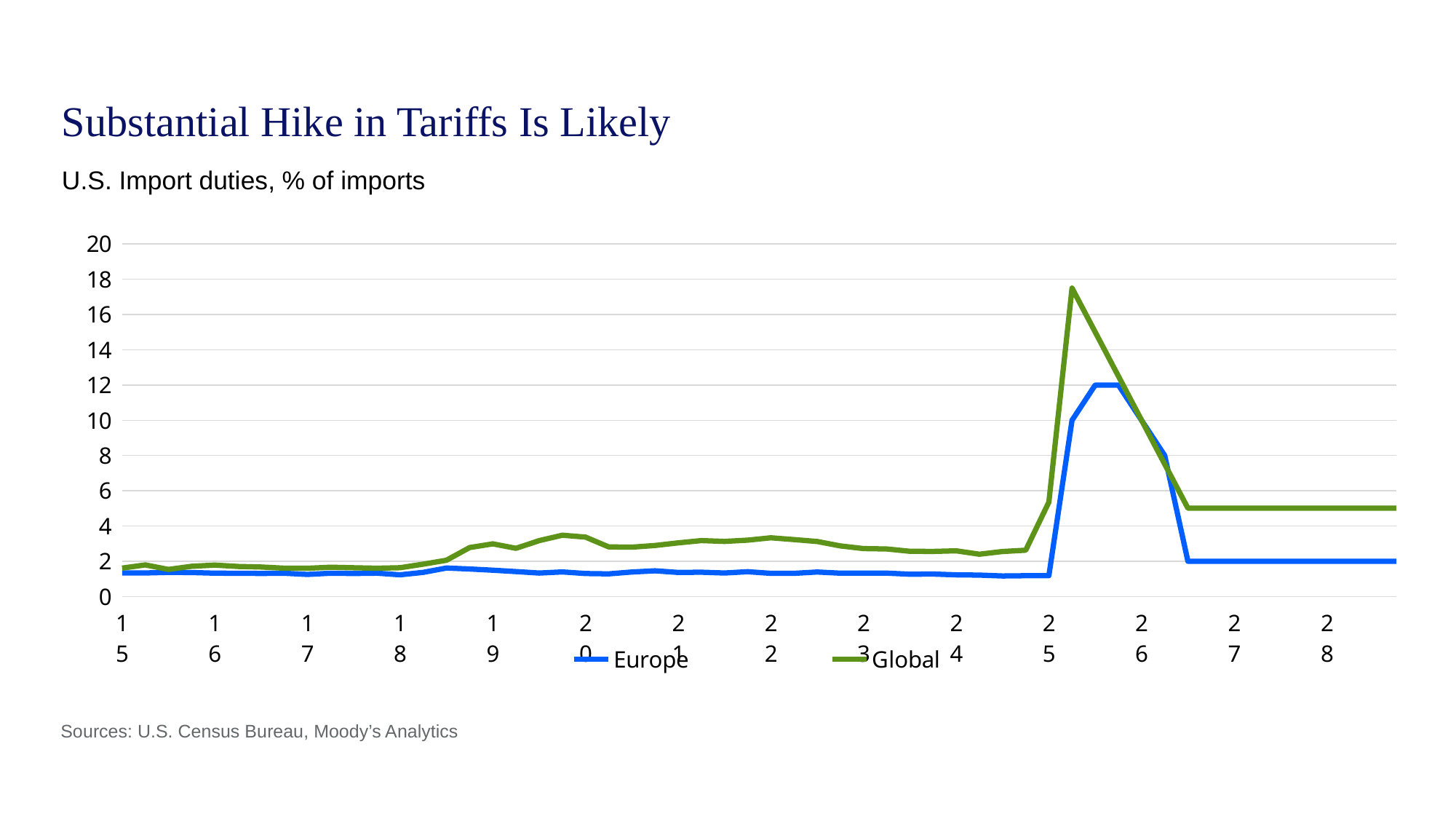
How many series does the legend list? 2 Is the peak value of the Europe series greater or less than 10? greater How many year labels are shown along the x axis? 14 Is the value of the Global series at the right end of the chart (28) greater or less than 4? greater Is the value of the Europe series at the right end of the chart (28) greater or less than 4? less Which two series are shown in the legend? Europe and Global Which series reaches the higher peak, Europe or Global? Global What is the subtitle describing the chart's measure? U.S. Import duties, % of imports What kind of chart is shown on the slide? line chart At the right end of the chart (28), which series is higher, Europe or Global? Global Does the Europe series rise or fall between 26 and 27? fall